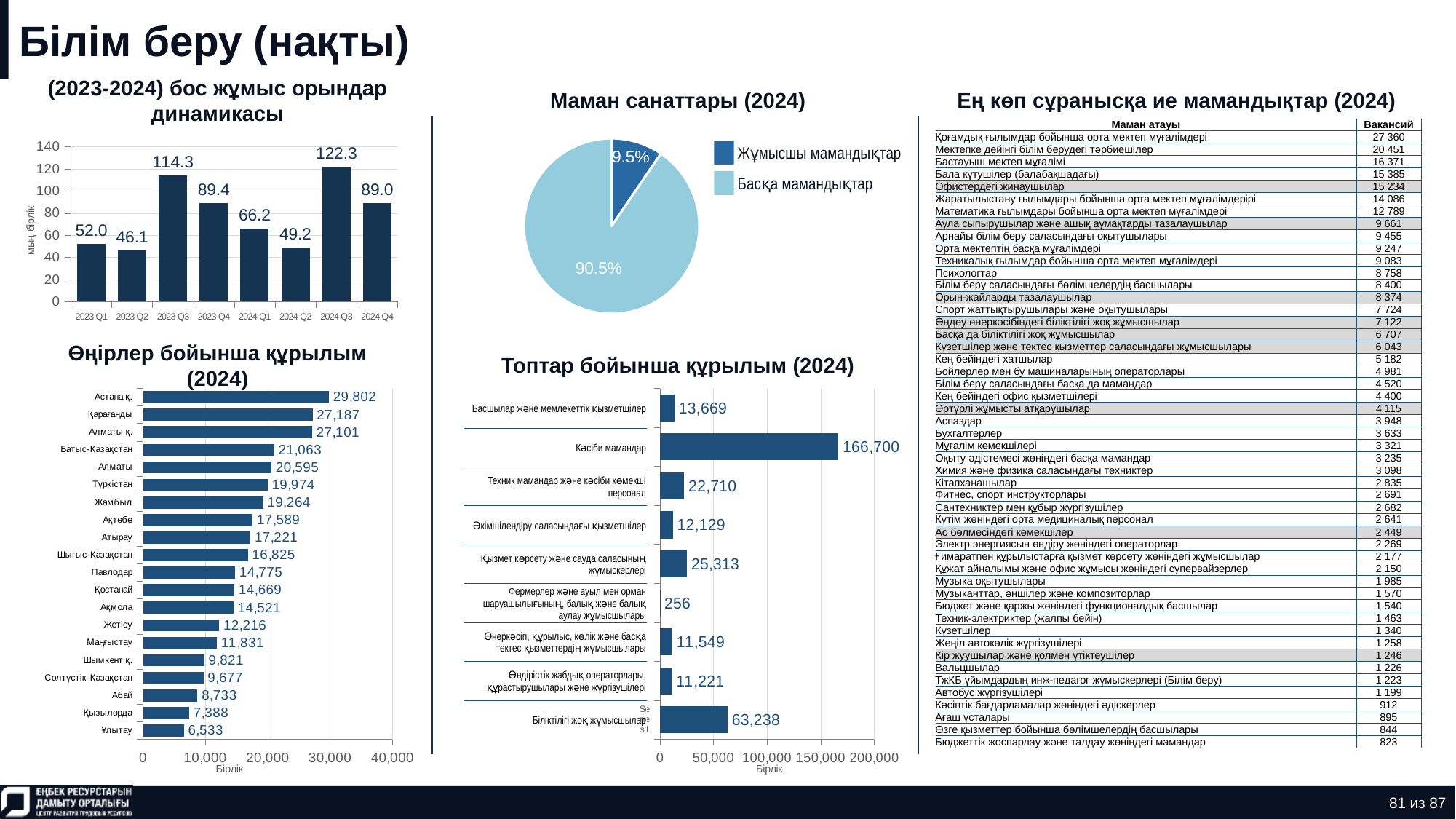
What kind of chart is 'Топтар бойынша құрылым (2024)'? Bar chart In the chart 'Өңірлер бойынша құрылым (2024)', which is larger, Павлодар or Қостанай? Павлодар In the chart 'Топтар бойынша құрылым (2024)', what is the value for 'Кәсіби мамандар'? 166,700 In the chart 'Топтар бойынша құрылым (2024)', which group has the lowest value? Фермерлер және ауыл мен орман шаруашылығының, балық және балық аулау жұмысшылары In the chart 'Өңірлер бойынша құрылым (2024)', what is the value for Жамбыл? 19,264 In the chart '(2023-2024) бос жұмыс орындар динамикасы', what is the difference between 2023 Q3 and 2023 Q4? 24.9 In the pie chart 'Маман санаттары (2024)', how many categories does the legend list? 2 In the chart '(2023-2024) бос жұмыс орындар динамикасы', which quarter has the lowest value? 2023 Q2 In the chart '(2023-2024) бос жұмыс орындар динамикасы', what is the value for 2024 Q3? 122.3 In the chart 'Өңірлер бойынша құрылым (2024)', which region has the highest value? Астана қ. In the pie chart 'Маман санаттары (2024)', what share does 'Жұмысшы мамандықтар' have? 9.5% In the chart '(2023-2024) бос жұмыс орындар динамикасы', how many quarters are plotted? 8